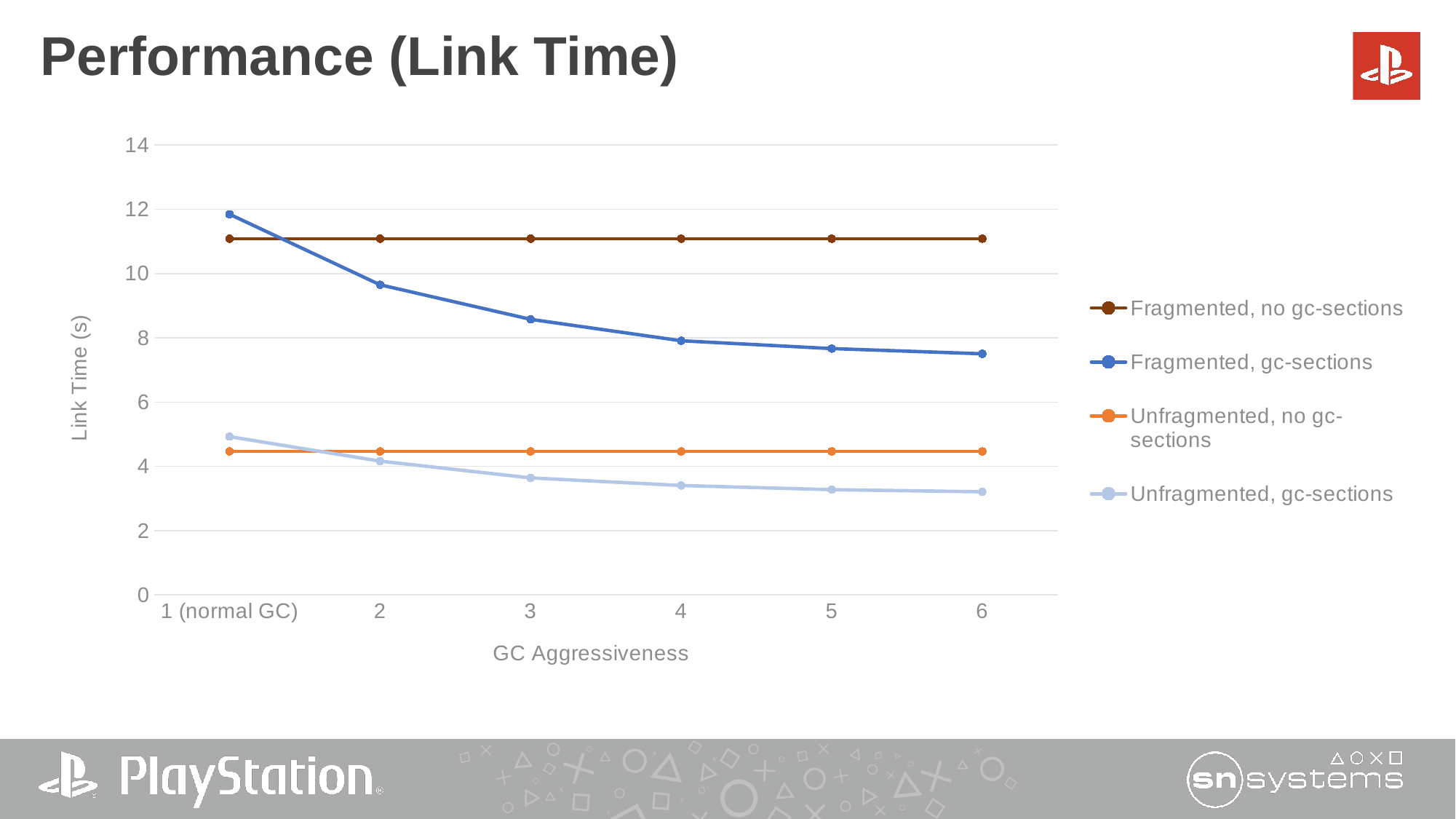
Which series has the highest link time at GC Aggressiveness 6? Fragmented, no gc-sections Is the link time for 'Fragmented, gc-sections' at 1 (normal GC) greater or less than 10? greater Does the link time for 'Fragmented, no gc-sections' rise, fall or stay flat as GC Aggressiveness increases? stay flat How many series does the legend list? 4 What kind of chart is shown on the slide? line chart How many GC Aggressiveness levels are plotted along the x axis? 6 Is the link time for 'Fragmented, gc-sections' at GC Aggressiveness 6 greater or less than 8? less What is the label of the y axis? Link Time (s) At GC Aggressiveness 3, which has the higher link time: 'Unfragmented, no gc-sections' or 'Unfragmented, gc-sections'? Unfragmented, no gc-sections Is the link time for 'Unfragmented, gc-sections' at GC Aggressiveness 6 greater or less than 4? less At 1 (normal GC), which has the higher link time: 'Fragmented, gc-sections' or 'Fragmented, no gc-sections'? Fragmented, gc-sections Does the link time for 'Fragmented, gc-sections' rise or fall as GC Aggressiveness increases? fall